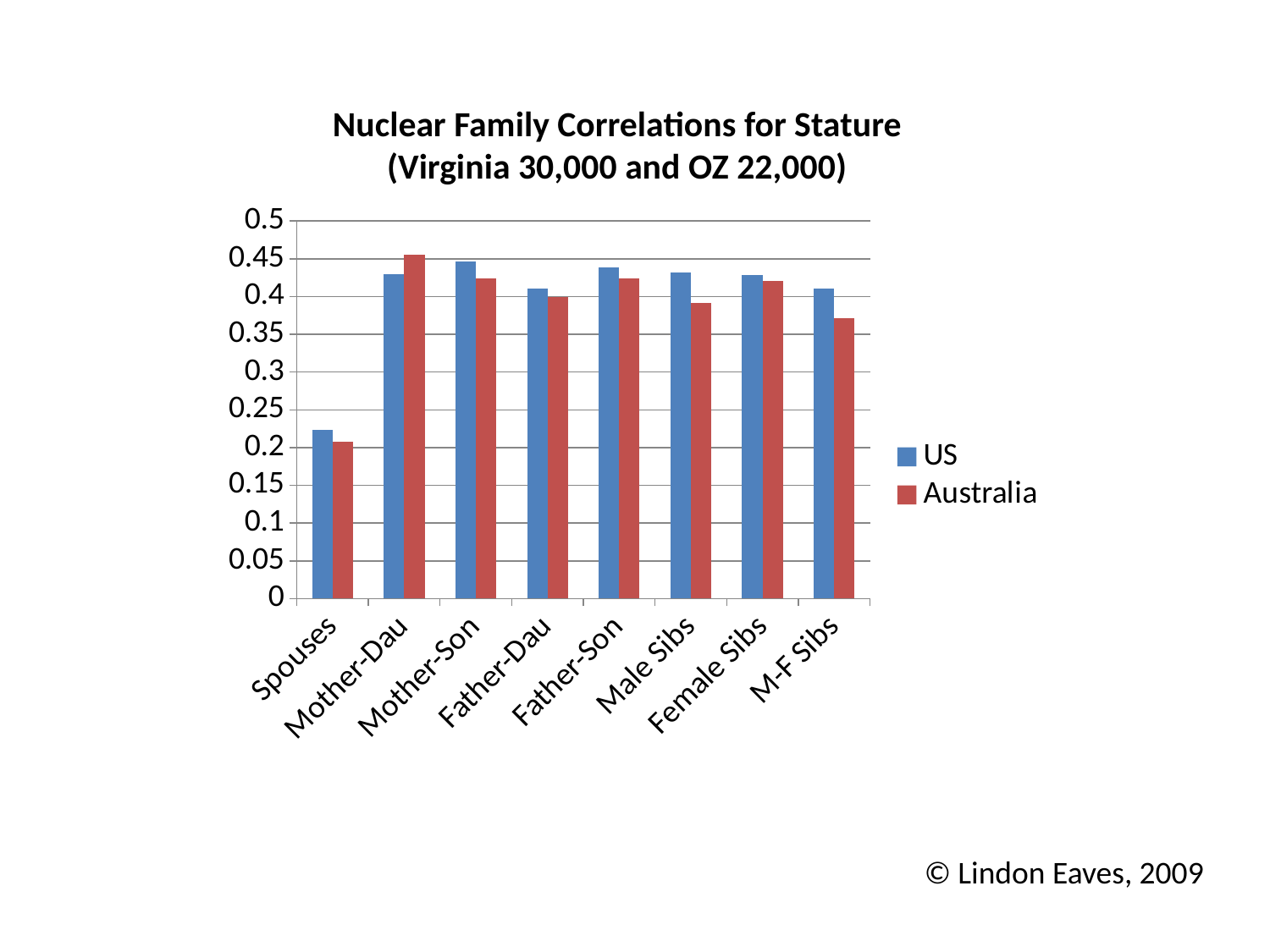
Which series is shown in red? Australia For Mother-Dau, which is larger, the US or the Australia correlation? Australia How many series does the legend list? 2 Which category has the lowest Australia correlation? Spouses What kind of chart is shown on the slide? bar chart Is the US value for Spouses greater or less than 0.25? less Which category has the highest Australia correlation? Mother-Dau Is the US value for Mother-Son greater or less than 0.4? greater Which category has the lowest US correlation? Spouses How many family relationship categories are shown on the x axis? 8 Is the Australia value for M-F Sibs greater or less than 0.4? less For Male Sibs, which is larger, the US or the Australia correlation? US